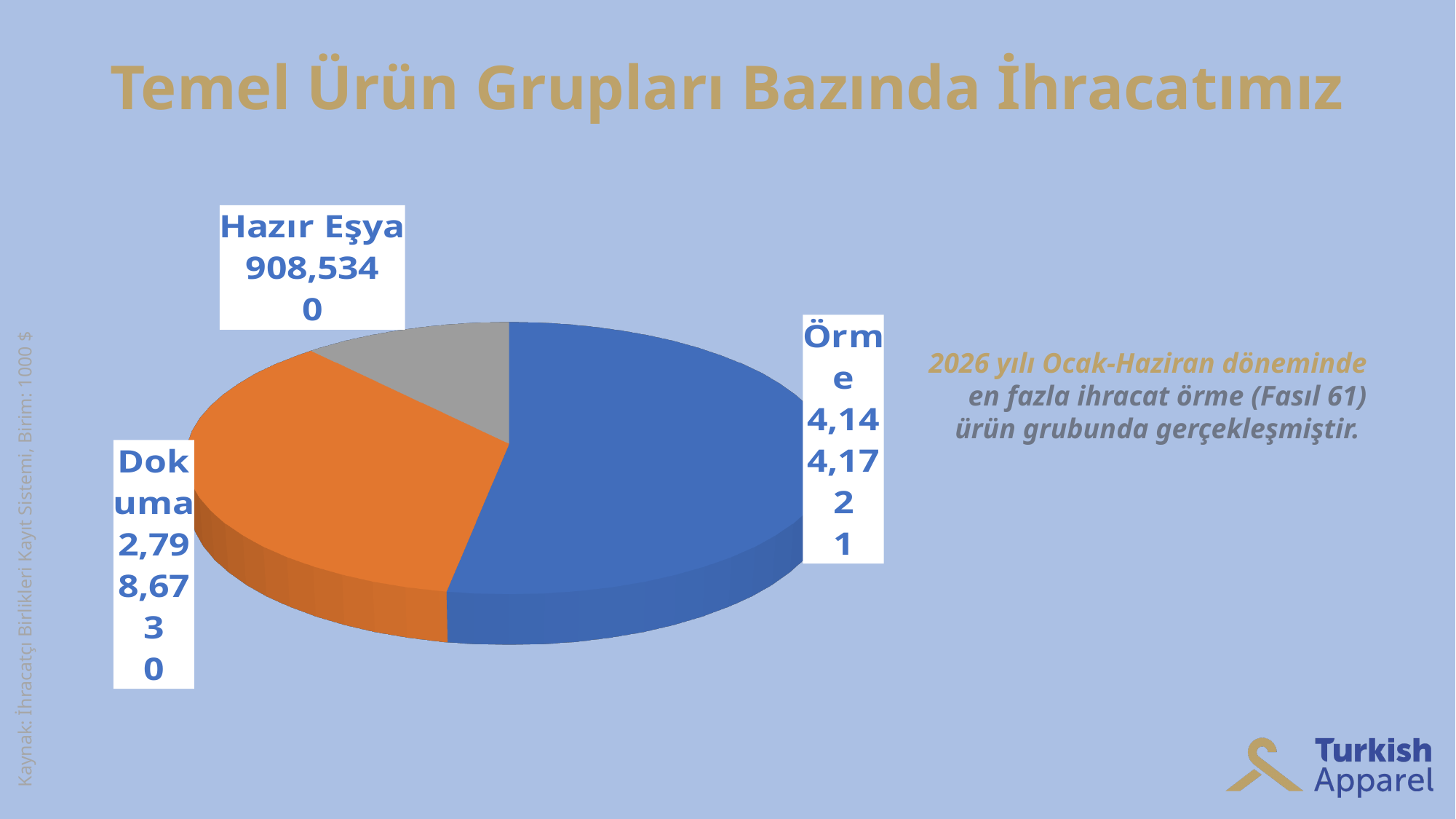
Which product group has the smallest slice of the pie? Hazır Eşya What colour is the Örme slice in the pie chart? blue How many product groups (slices) does the pie chart show? 3 Which is larger, the slice for Örme or the slice for Dokuma? Örme What is the title of the slide containing the pie chart? Temel Ürün Grupları Bazında İhracatımız What kind of chart is shown on the slide? pie chart Which is larger, the slice for Dokuma or the slice for Hazır Eşya? Dokuma Which product group has the largest slice of the pie? Örme